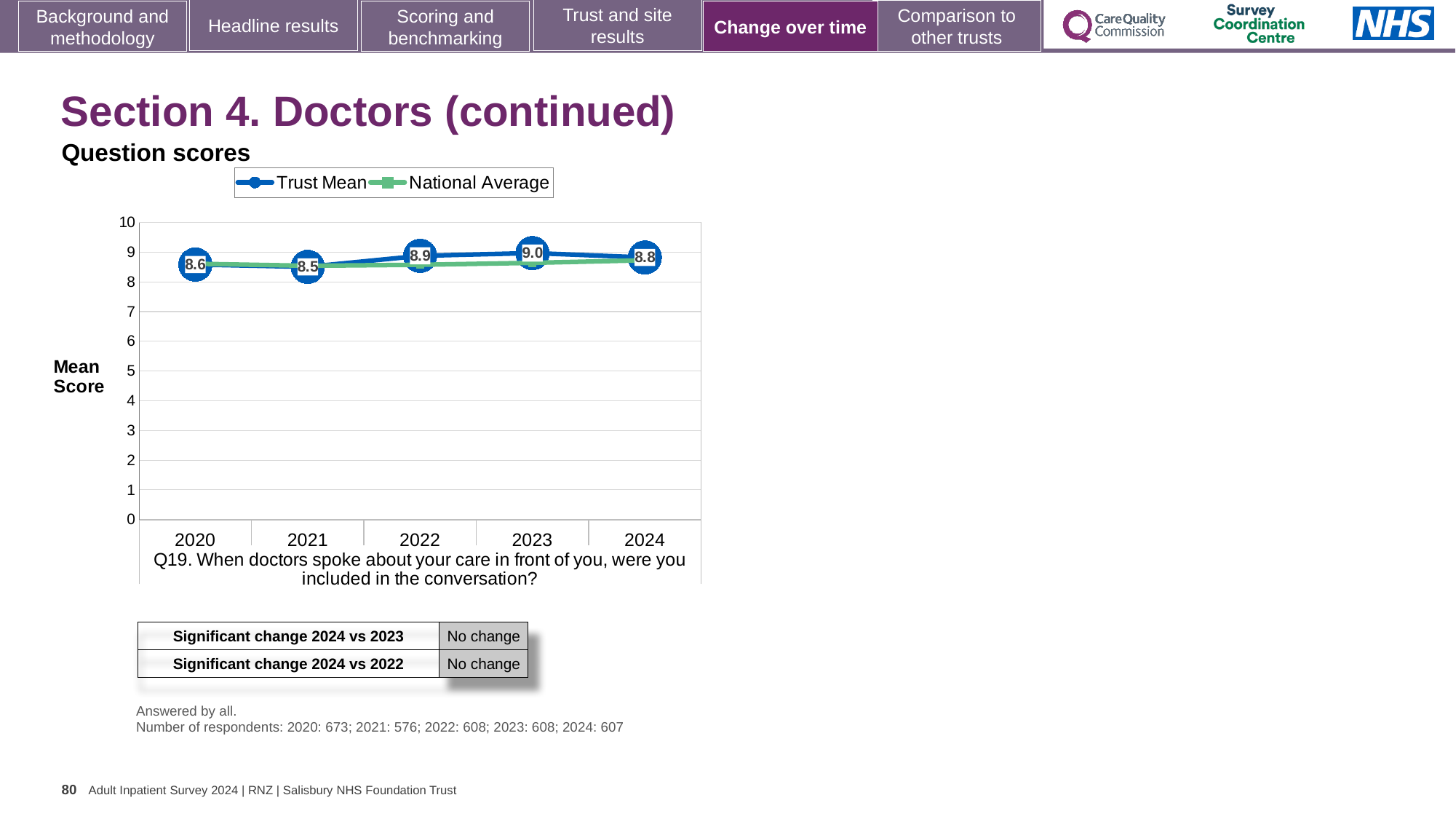
In which year is the Trust Mean lowest? 2021 What is the Trust Mean score for 2020? 8.6 In which year is the Trust Mean highest? 2023 Does the Trust Mean rise or fall from 2021 to 2023? Rise How many series does the legend list? 2 Which year has the larger Trust Mean, 2022 or 2024? 2022 What kind of chart is shown on the slide? Line chart Is the National Average value for 2024 greater or less than 8? greater What is the difference between the Trust Mean in 2023 and in 2021? 0.5 What is the Trust Mean score for 2023? 9.0 How many years are plotted on the x axis? 5 What is the Trust Mean score for 2024? 8.8